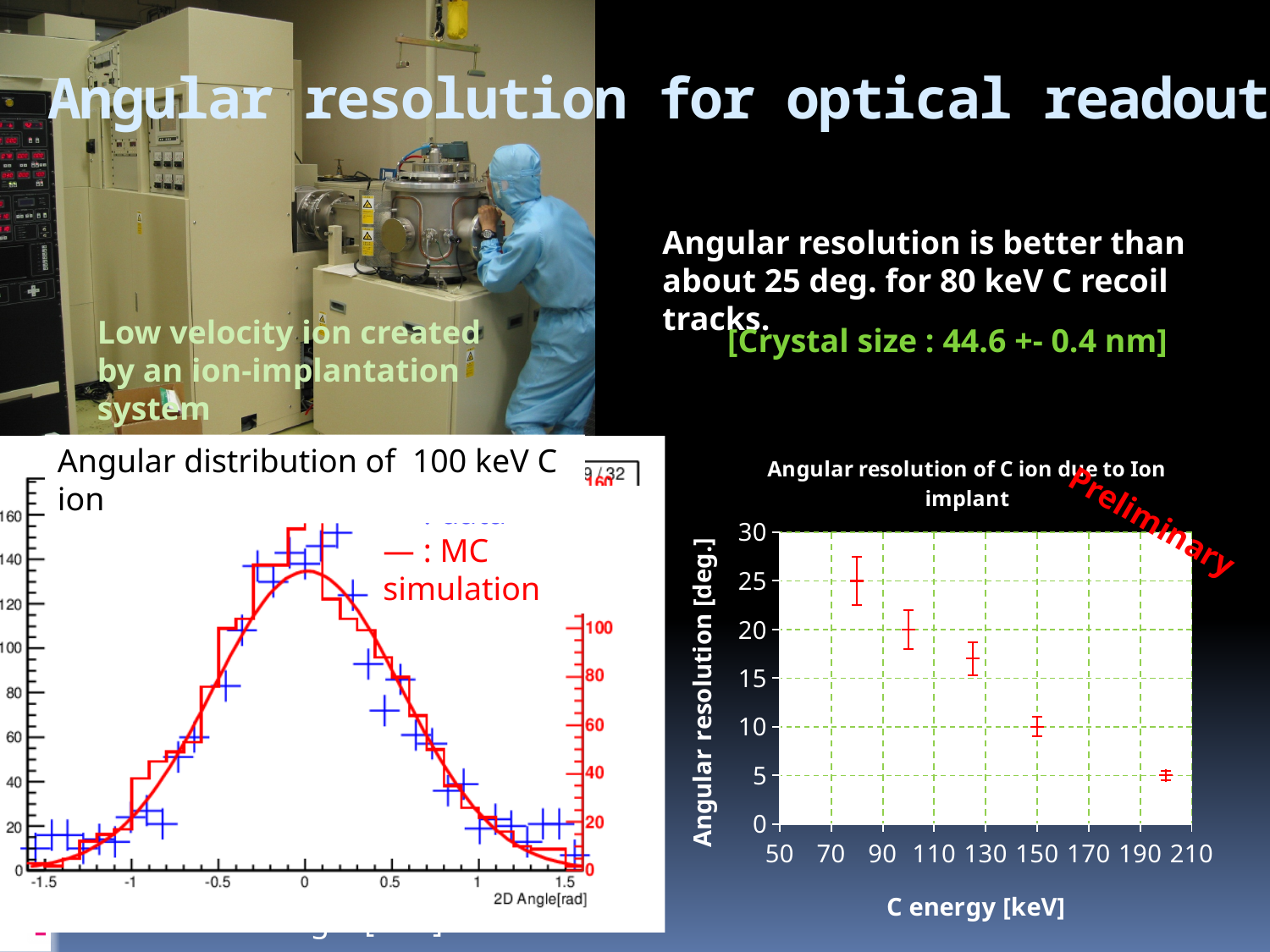
In the chart on the bottom left, 'Angular distribution of 100 keV C ion', what is the x-axis label? 2D Angle[rad] In the chart titled 'Angular resolution of C ion due to Ion implant', is the angular resolution larger at about 100 keV or at about 150 keV? about 100 keV In the chart titled 'Angular resolution of C ion due to Ion implant', is the angular resolution at about 80 keV greater or less than 20 deg.? greater In the chart on the bottom left, 'Angular distribution of 100 keV C ion', does the distribution rise or fall as the 2D angle goes from 0 to 1.5 rad? fall In the chart titled 'Angular resolution of C ion due to Ion implant', how many data points are plotted? 5 In the chart titled 'Angular resolution of C ion due to Ion implant', is the angular resolution at about 200 keV greater or less than 10 deg.? less In the chart titled 'Angular resolution of C ion due to Ion implant', does the angular resolution rise or fall as C energy increases? fall What is the y-axis label of the chart titled 'Angular resolution of C ion due to Ion implant'? Angular resolution [deg.] In the chart titled 'Angular resolution of C ion due to Ion implant', is the angular resolution at about 150 keV greater or less than 15 deg.? less What is the x-axis label of the chart titled 'Angular resolution of C ion due to Ion implant'? C energy [keV]